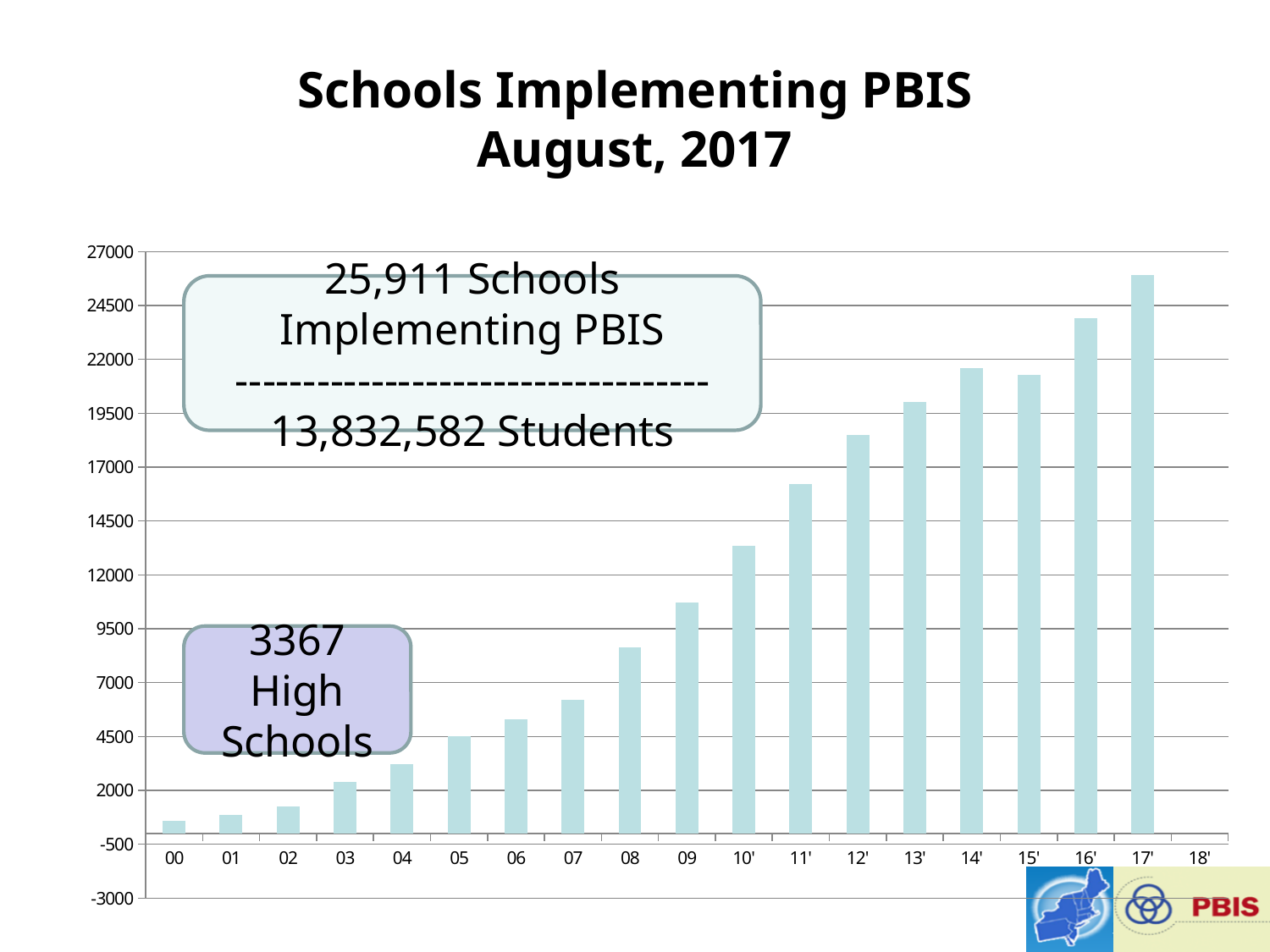
Which year has the shortest bar? 00 Is the value for 11' greater or less than 17000? less Is the value for 06 greater or less than 4500? greater Is the value for 17' greater or less than 24500? greater What is the title of the chart? Schools Implementing PBIS August, 2017 Which year has the tallest bar? 17' How many year labels are shown on the x axis? 19 Which is larger, the value for 16' or the value for 15'? 16' Do the values generally rise or fall from 00 to 17'? rise What kind of chart is shown on the slide? bar chart